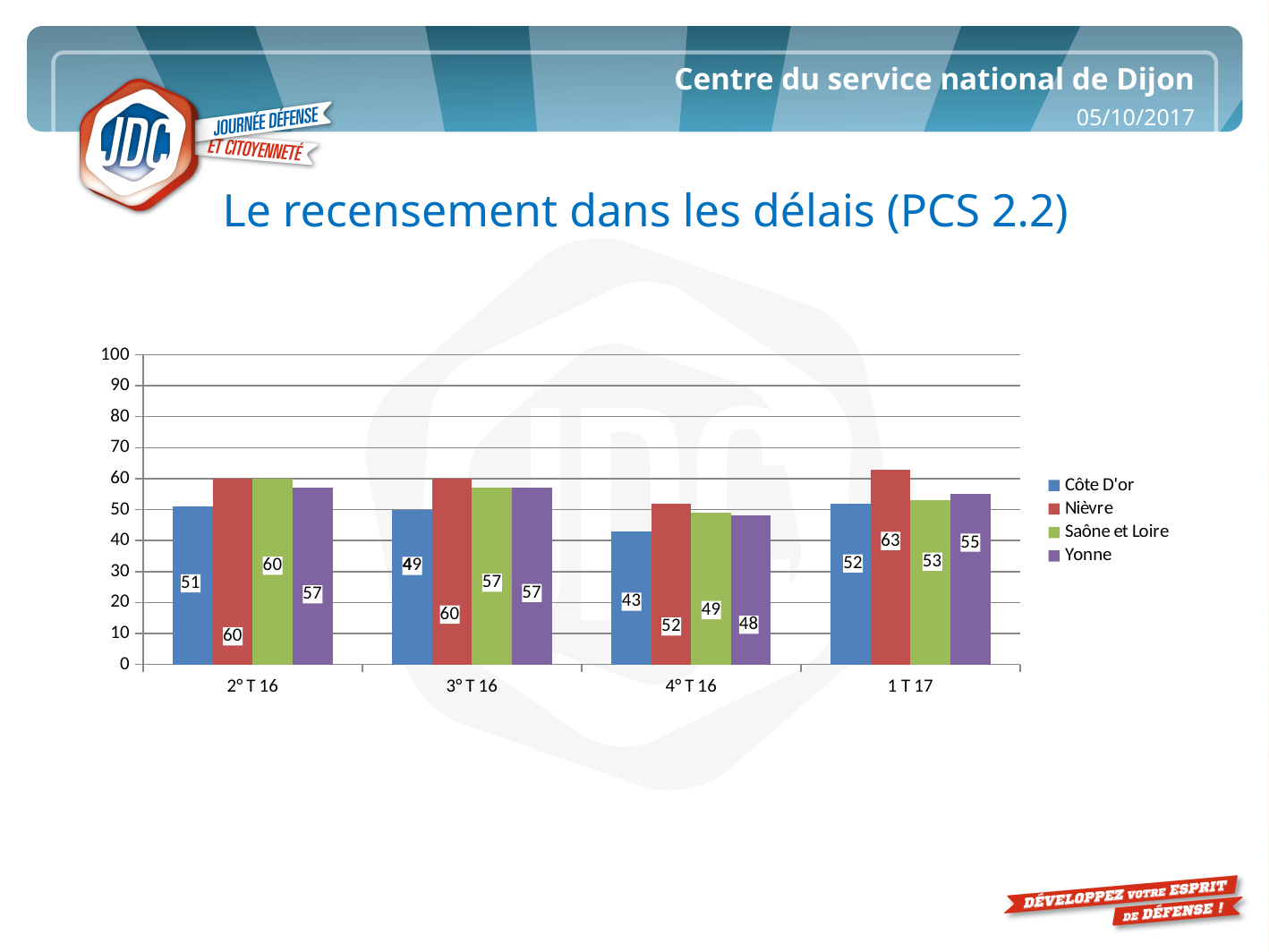
What is the value for Saône et Loire in 3° T 16? 57 How many series does the legend list? 4 What kind of chart is shown on the slide? Bar chart Which series has the lowest value in 4° T 16? Côte D'or What is the value for Côte D'or in 4° T 16? 43 What is the title of the slide above the chart? Le recensement dans les délais (PCS 2.2) What is the value for Yonne in 2° T 16? 57 What is the value for Nièvre in 1 T 17? 63 How many categories are shown on the x axis? 4 Which is larger in 2° T 16: the value for Côte D'or or the value for Yonne? Yonne What is the difference between the Nièvre and Côte D'or values in 1 T 17? 11 Which series has the highest value in 1 T 17? Nièvre